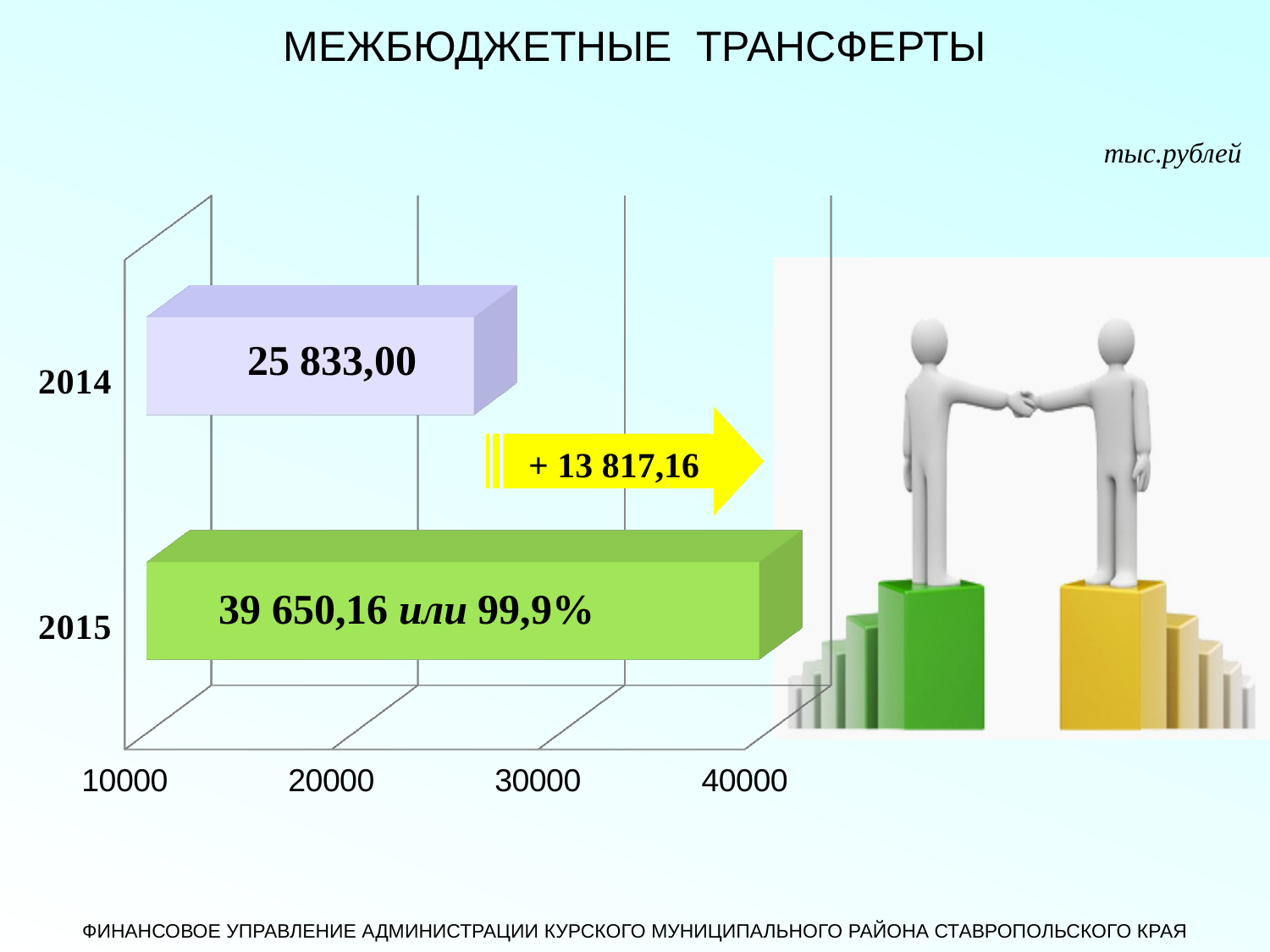
Which year has the higher value, 2014 or 2015? 2015 What unit of measurement is indicated for the chart? тыс.рублей What percentage is shown next to the 2015 value? 99,9% How many years (categories) are shown in the chart? 2 Which year has the lowest value? 2014 What kind of chart is shown on the slide? bar chart What is the value for 2015? 39 650,16 What is the difference between the 2015 and 2014 values? 13 817,16 Which year has the highest value? 2015 Is the value for 2014 greater or less than 30000? less Is the value for 2015 greater or less than 30000? greater What is the value for 2014? 25 833,00